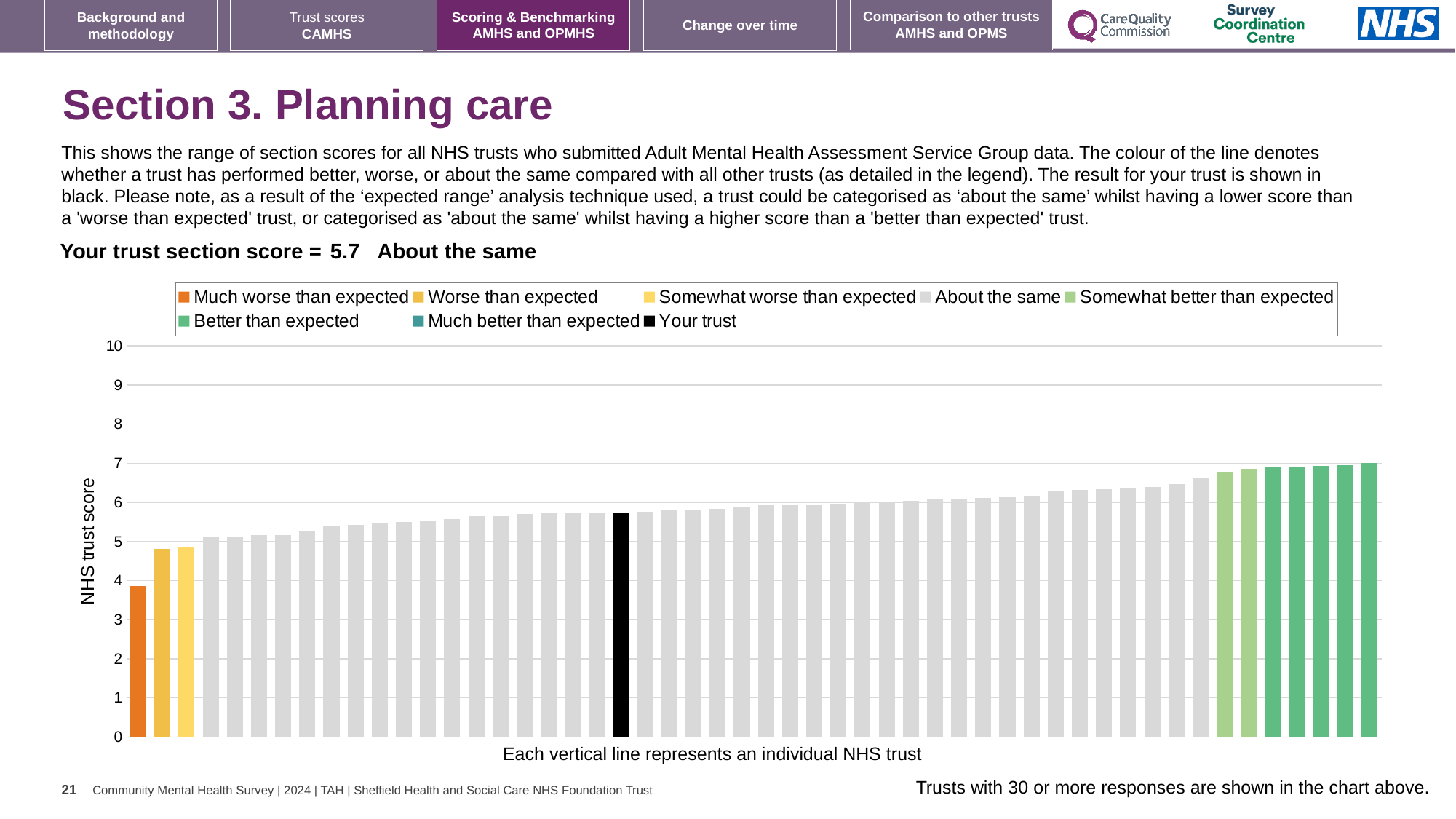
How many bars are coloured dark green (Better than expected)? 5 Which legend category does the lowest bar in the chart belong to? Much worse than expected Is the value of the lowest bar (the orange bar) greater or less than 5? less What is the label on the vertical axis of the chart? NHS trust score Is the value for your trust (the black bar) greater or less than 5? greater Do the bar values rise or fall from left to right across the chart? rise What kind of chart is shown on the slide? bar chart Which category is your trust placed in for this section? About the same How many bars are coloured orange (Much worse than expected)? 1 Is the value of the highest bar greater or less than 6? greater What is the section score for your trust? 5.7 How many entries does the chart legend list? 8